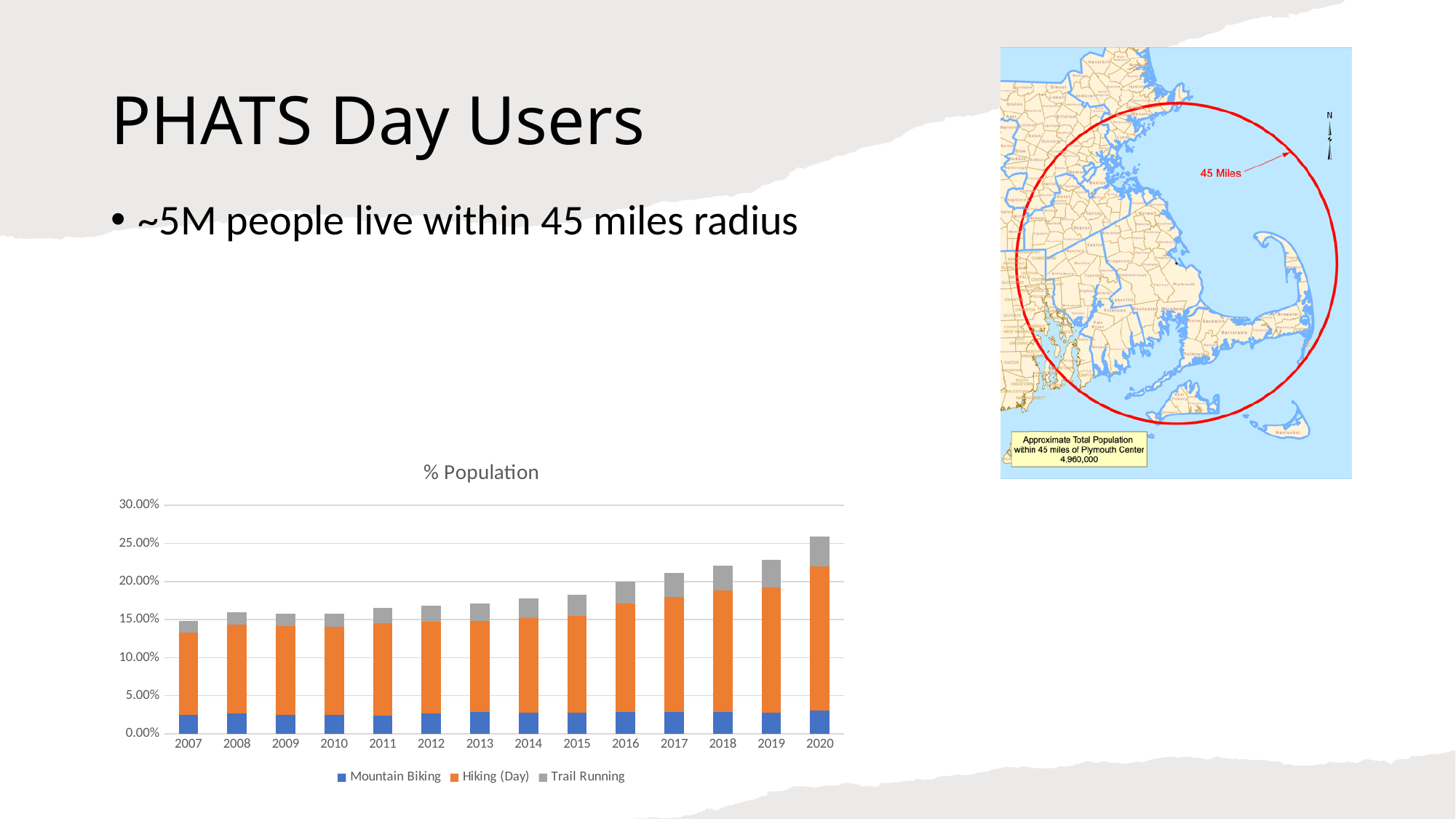
What kind of chart is the "% Population" chart? stacked bar chart Do the total stacked values generally rise or fall from 2007 to 2020? rise Is the Mountain Biking value for 2020 greater or less than 5.00%? less Which year has the lowest total stacked bar in the "% Population" chart? 2007 How many series does the legend of the "% Population" chart list? 3 Is the total stacked value for 2013 greater or less than 20.00%? less Is the total stacked value for 2020 greater or less than 20.00%? greater What is the title of the chart on the slide? % Population Which series are listed in the legend of the "% Population" chart? Mountain Biking, Hiking (Day), Trail Running Which year has the highest total stacked bar in the "% Population" chart? 2020 Which year has the larger total stacked bar, 2007 or 2020? 2020 How many years are shown on the x axis of the "% Population" chart? 14